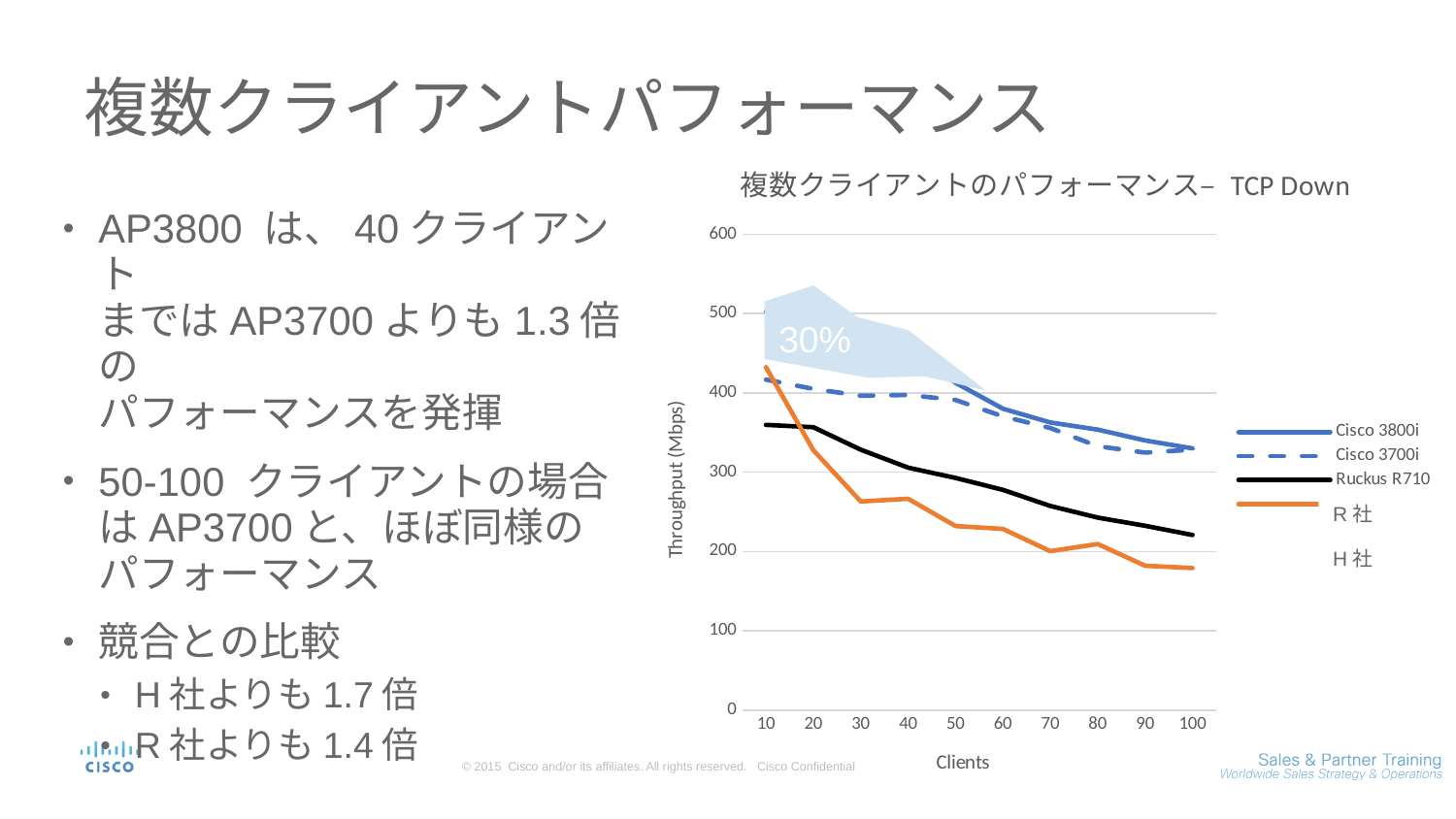
At 100 clients, which has the higher throughput, Ruckus R710 or R社? Ruckus R710 How many series does the chart legend list? 4 Does the Cisco 3800i throughput rise or fall as the number of clients increases? fall Is the Cisco 3700i throughput at 10 clients greater or less than 500? less What kind of chart is shown on the slide? line chart What is the title of the chart? 複数クライアントのパフォーマンス– TCP Down Is the Ruckus R710 throughput at 100 clients greater or less than 300? less Is the Cisco 3800i throughput at 10 clients greater or less than 400? greater Which series has the lowest throughput at 100 clients? R社 How many client values are plotted along the x axis? 10 What is the label of the y axis? Throughput (Mbps)